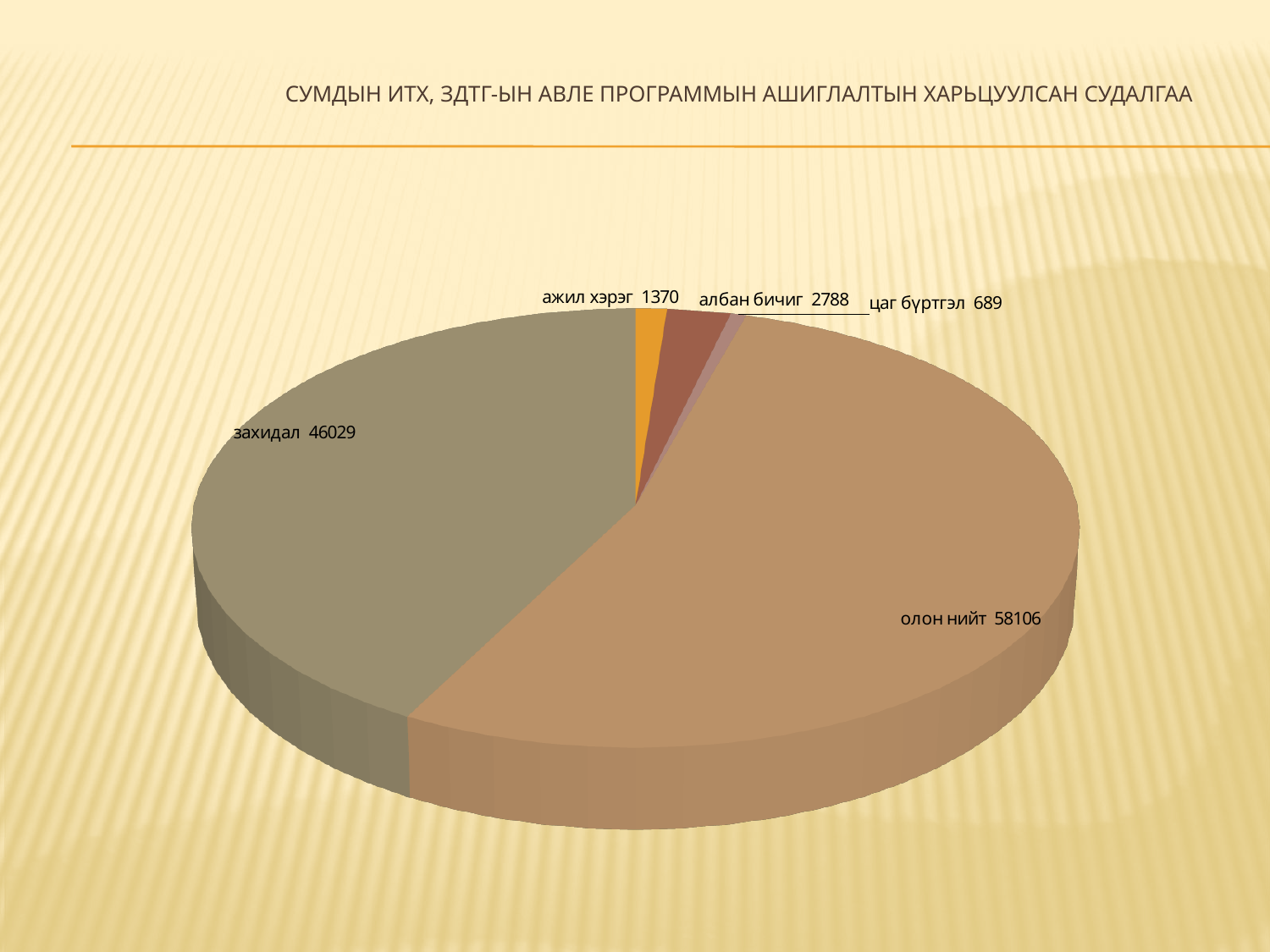
Which category has the smallest slice? цаг бүртгэл What is the total of all slices in the pie chart? 108982 How many slices does the pie chart have? 5 What kind of chart is shown on the slide? pie chart What is the value for олон нийт? 58106 What is the value for цаг бүртгэл? 689 Which is larger, албан бичиг or ажил хэрэг? албан бичиг What is the title of the chart on the slide? СУМДЫН ИТХ, ЗДТГ-ЫН АВЛЕ ПРОГРАММЫН АШИГЛАЛТЫН ХАРЬЦУУЛСАН СУДАЛГАА Which category has the largest slice? олон нийт What is the value for албан бичиг? 2788 What is the difference between the values for олон нийт and захидал? 12077 What is the value for захидал? 46029